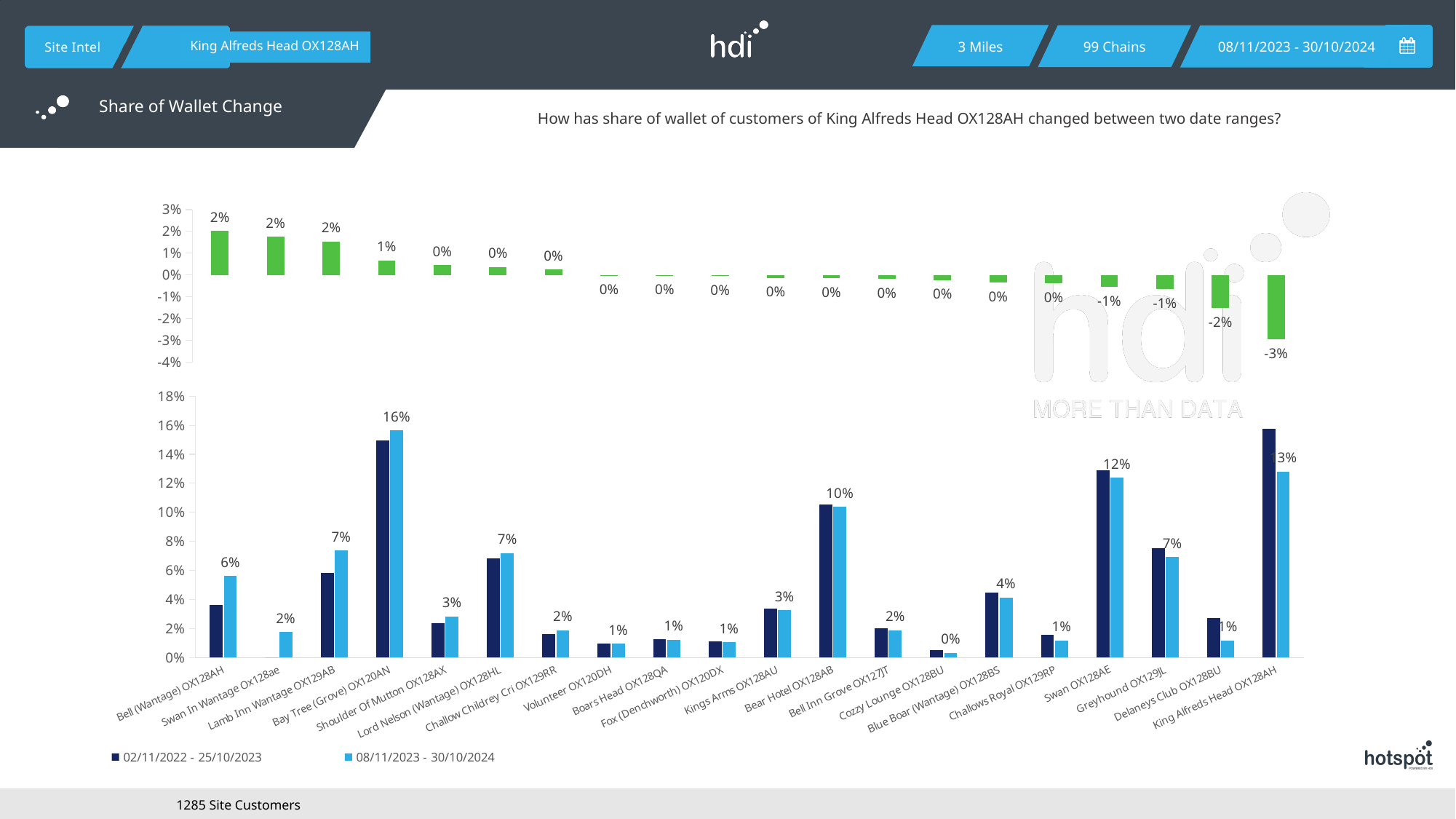
In the bottom chart, which category has the highest value in the 08/11/2023 - 30/10/2024 series? Bay Tree (Grove) OX120AN In the bottom chart, for King Alfreds Head OX128AH, which series has the larger value? 02/11/2022 - 25/10/2023 In the bottom chart, is the 02/11/2022 - 25/10/2023 value for Bear Hotel OX128AB greater or less than 8%? greater How many series does the legend of the bottom chart list? 2 How many categories are shown on the x axis of the bottom chart? 20 In the bottom chart, what is the difference between the 08/11/2023 - 30/10/2024 values for Bay Tree (Grove) OX120AN and Swan OX128AE? 4% In the top chart (Share of Wallet Change), what is the value of the last bar on the right? -3% In the bottom chart, for Bell (Wantage) OX128AH, which series has the larger value? 08/11/2023 - 30/10/2024 What kind of chart is the bottom chart on the slide? bar chart In the bottom chart, what is the value for Swan OX128AE in the 08/11/2023 - 30/10/2024 series? 12% In the bottom chart, what is the value for Bay Tree (Grove) OX120AN in the 08/11/2023 - 30/10/2024 series? 16% In the top chart (Share of Wallet Change), do the values rise or fall from left to right? fall